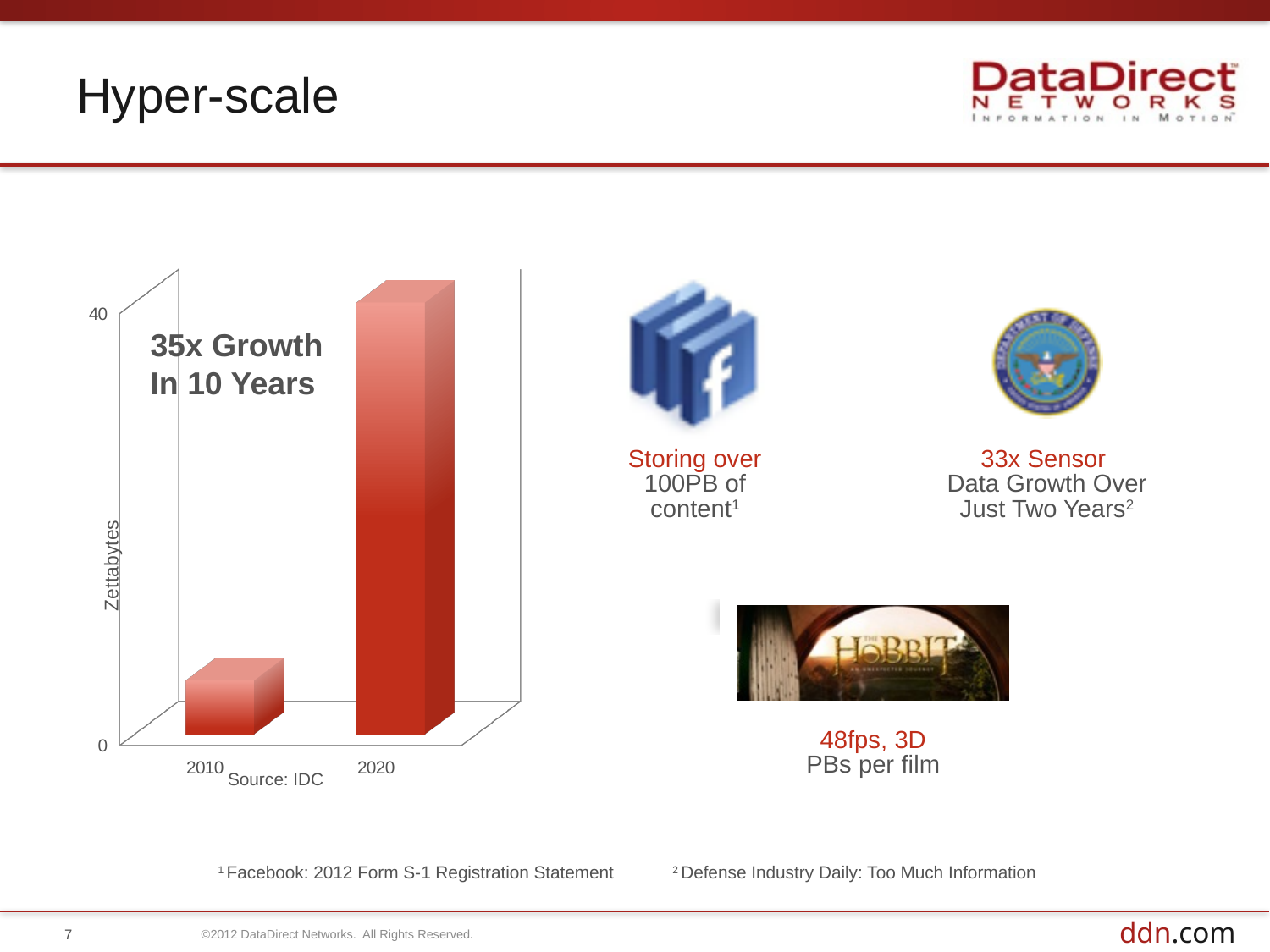
Which year has the lowest bar in the chart? 2010 What source is cited beneath the bar chart? IDC How many categories are plotted on the x axis of the bar chart? 2 What unit is shown on the vertical axis of the chart? Zettabytes Is the value for 2010 greater or less than 40 zettabytes? less What kind of chart is shown on the left of the slide? bar chart Which year has the highest bar in the chart? 2020 Is the bar for 2020 larger or smaller than the bar for 2010? larger Do the values rise or fall from 2010 to 2020 in the chart? rise